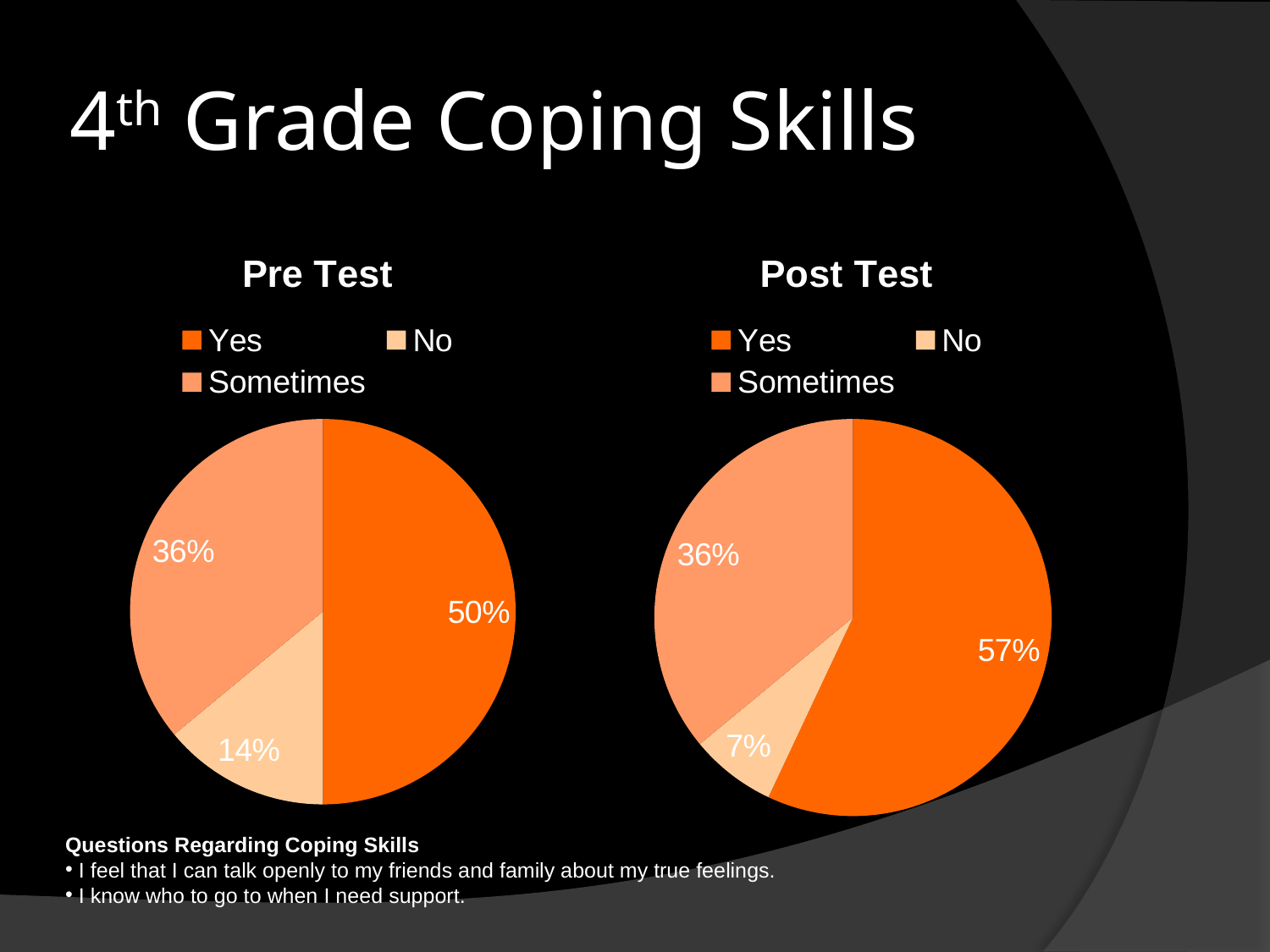
In the Pre Test chart, what percentage is shown for Yes? 50% In the Post Test chart, what percentage is shown for Yes? 57% Is the No slice larger in the Pre Test chart or the Post Test chart? Pre Test In the Post Test chart, which category has the smallest slice? No In the Post Test chart, what percentage is shown for No? 7% In the Pre Test chart, what percentage is shown for No? 14% What type of chart is the Pre Test chart? Pie chart What is the difference between the Yes percentage in the Post Test chart and the Yes percentage in the Pre Test chart? 7% In the Pre Test chart, which category has the largest slice? Yes In the Post Test chart, what percentage is shown for Sometimes? 36% How many categories does the legend of the Post Test chart list? 3 In the Pre Test chart, what is the difference between the Sometimes and No percentages? 22%